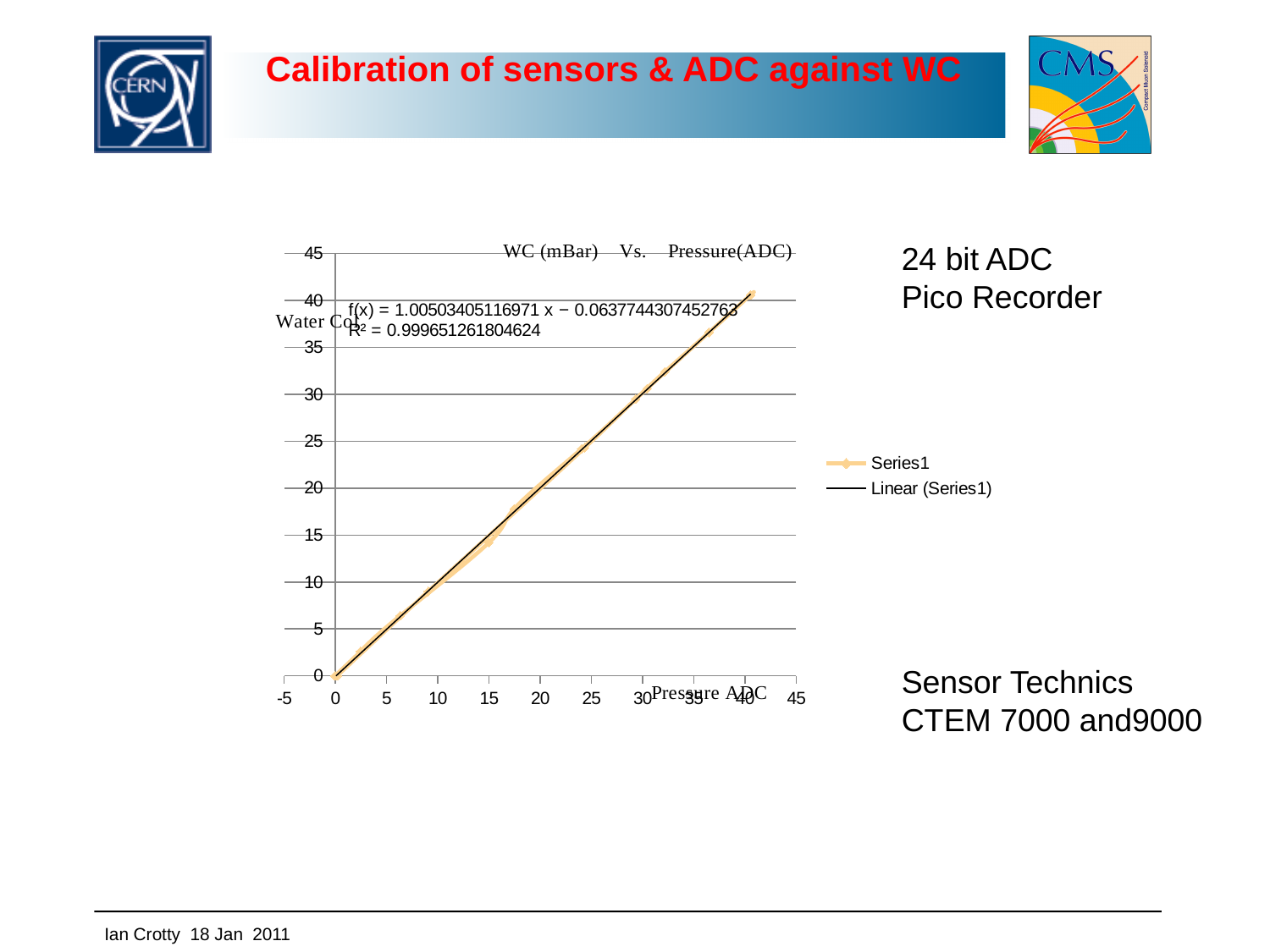
What are the two entries in the chart legend? Series1 and Linear (Series1) What is the title of the chart? WC (mBar) Vs. Pressure(ADC) Which has the larger Water Col value: the point at Pressure ADC about 25 or the point at Pressure ADC about 5? the point at Pressure ADC about 25 What is the trendline equation shown on the chart? f(x) = 1.00503405116971 x − 0.0637744307452763 Is the Water Col value at a Pressure ADC of about 10 greater or less than 15? less How many series does the chart legend list? 2 What is the highest value shown on the y axis of the chart? 45 Is the Water Col value at a Pressure ADC of about 40 greater or less than 35? greater What is the slope of the linear fit shown on the chart? 1.00503405116971 Do the plotted values rise or fall as Pressure ADC increases along the x axis? rise What is the R² value shown for the linear fit on the chart? 0.999651261804624 What kind of chart is shown on the slide? scatter chart with a linear trendline